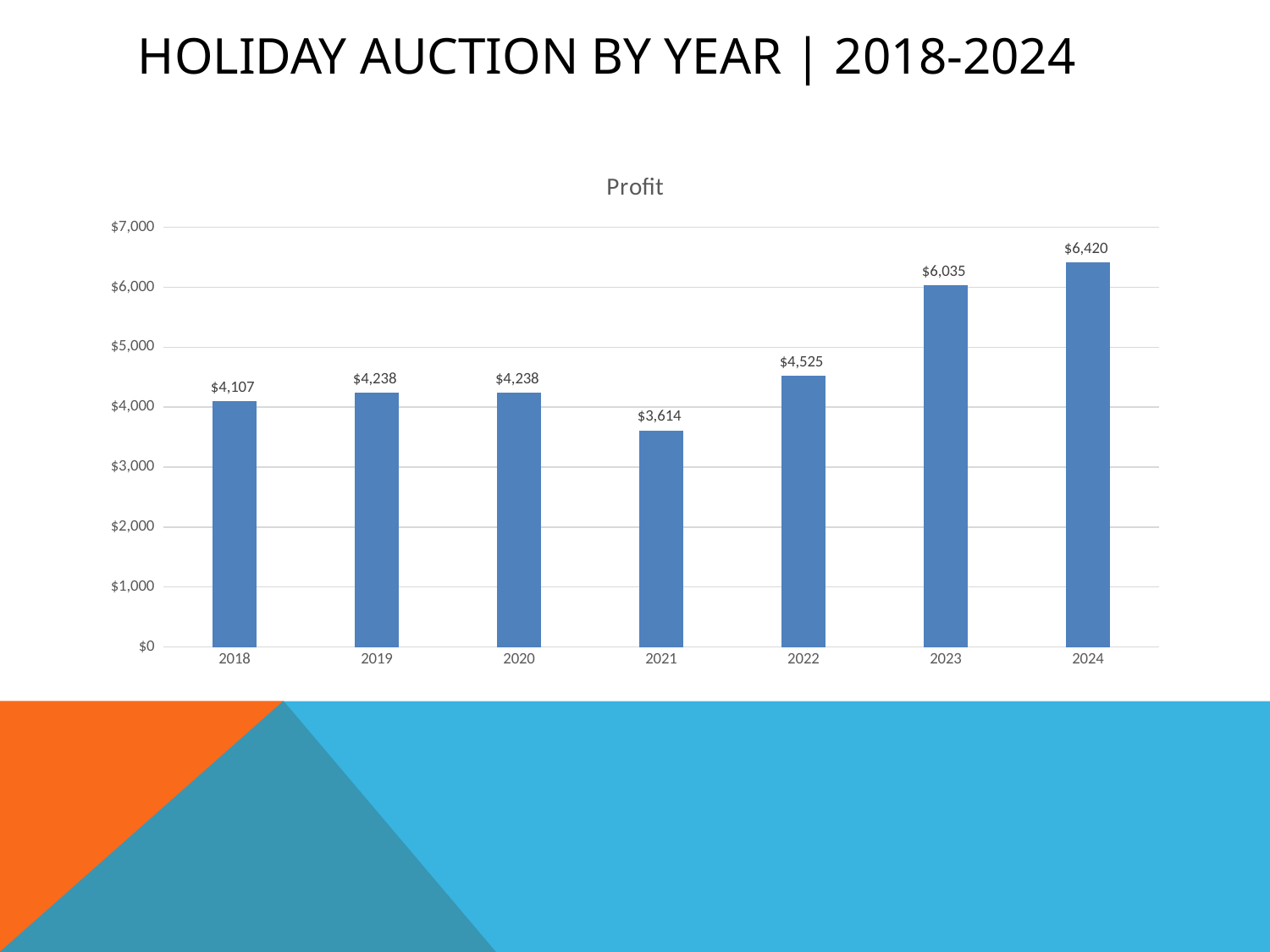
Is the profit for 2023 greater or less than $6,000? greater How many years are shown in the chart? 7 Which year has the highest profit? 2024 What is the difference in profit between 2024 and 2023? $385 What kind of chart is shown on the slide? Bar chart What is the profit for 2021? $3,614 What is the profit for 2018? $4,107 What is the profit for 2024? $6,420 What is the title of the chart? Profit Which year has the larger profit, 2018 or 2022? 2022 Which year has the lowest profit? 2021 What is the difference in profit between 2022 and 2021? $911